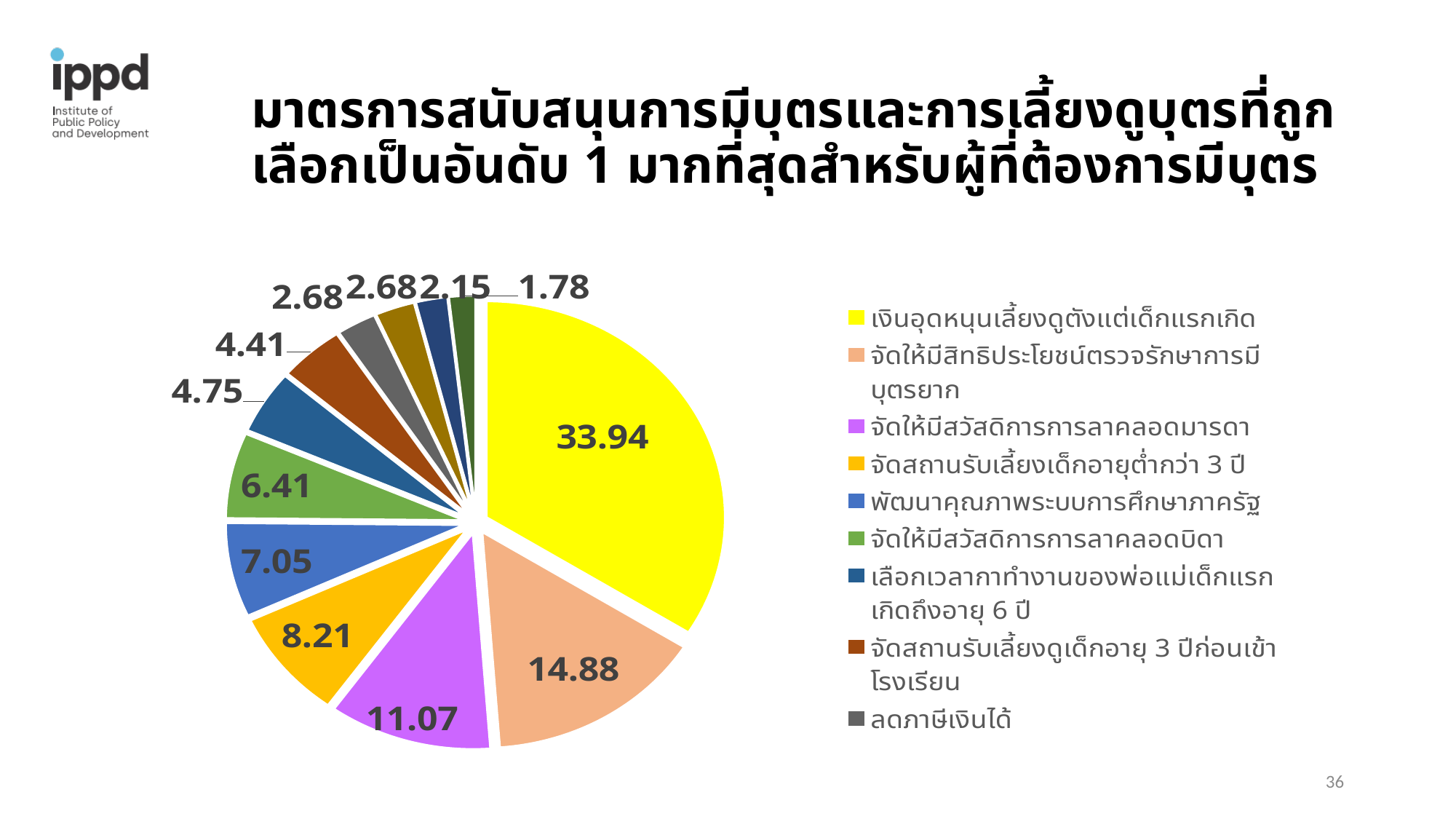
What value is shown for จัดให้มีสวัสดิการการลาคลอดมารดา? 11.07 What is the difference between the values for เงินอุดหนุนเลี้ยงดูตั้งแต่เด็กแรกเกิด and จัดให้มีสิทธิประโยชน์ตรวจรักษาการมีบุตรยาก? 19.06 What value is shown for จัดให้มีสวัสดิการการลาคลอดบิดา? 6.41 What value is shown for จัดสถานรับเลี้ยงเด็กอายุต่ำกว่า 3 ปี? 8.21 What value is shown for เงินอุดหนุนเลี้ยงดูตั้งแต่เด็กแรกเกิด? 33.94 Which category has the largest slice of the pie? เงินอุดหนุนเลี้ยงดูตั้งแต่เด็กแรกเกิด How many slices does the pie chart have? 12 What is the smallest value labelled on the pie chart? 1.78 Which is larger: the value for พัฒนาคุณภาพระบบการศึกษาภาครัฐ or the value for จัดให้มีสวัสดิการการลาคลอดบิดา? พัฒนาคุณภาพระบบการศึกษาภาครัฐ What value is shown for ลดภาษีเงินได้? 2.68 What kind of chart is shown on the slide? pie chart What value is shown for จัดให้มีสิทธิประโยชน์ตรวจรักษาการมีบุตรยาก? 14.88